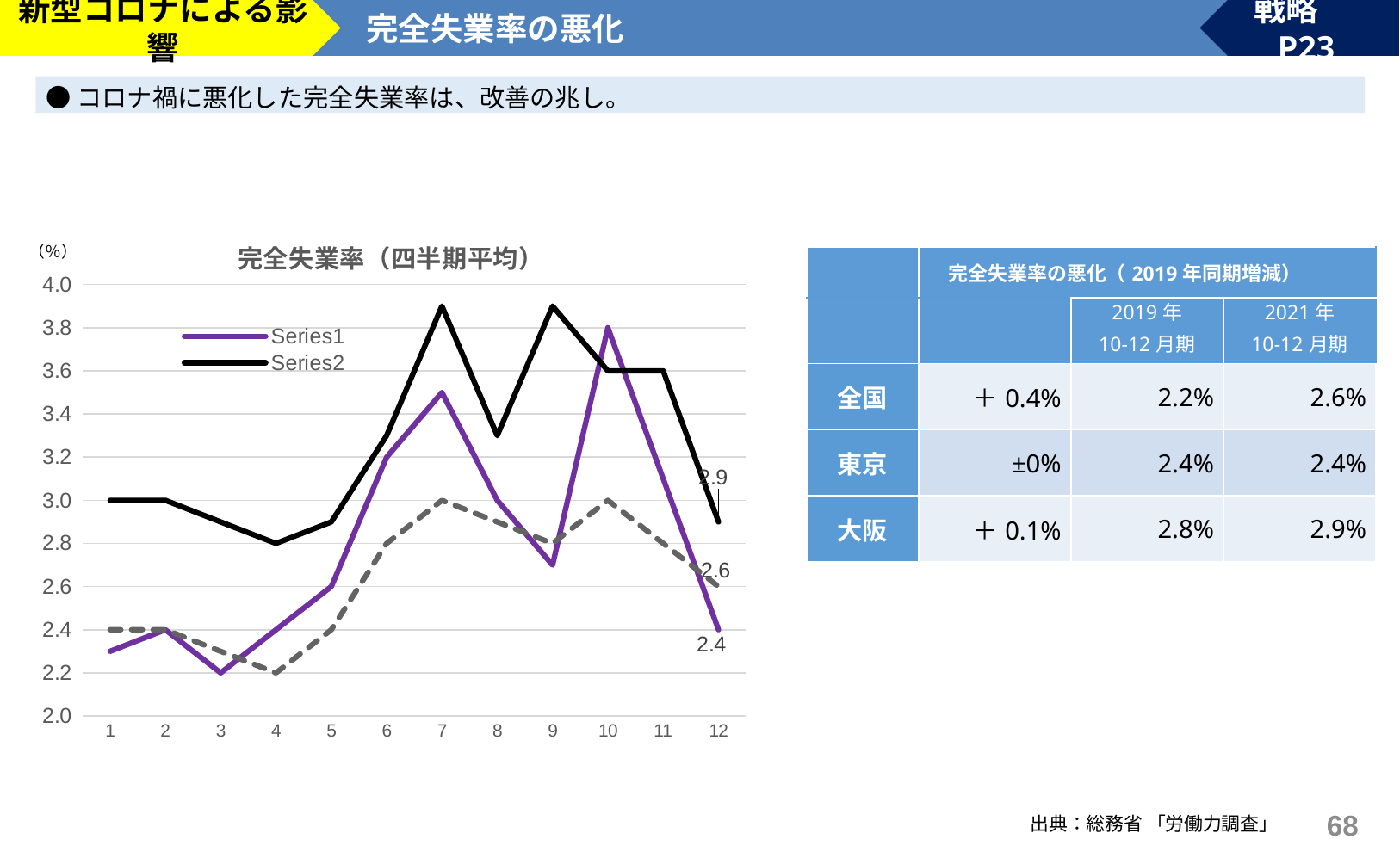
What is the value of Series2 at point 12? 2.9 Is the value of Series1 at point 3 greater or less than 2.4? less Does Series1 rise or fall from point 10 to point 12? fall What is the value of Series1 at point 12? 2.4 What kind of chart is shown on the slide? line chart Is the value of Series2 at point 7 greater or less than 3.6? greater At point 12, which is larger, Series1 or Series2? Series2 How many series does the chart legend list? 2 What is the difference between Series2 and Series1 at point 12? 0.5 How many points are on the x axis of the chart? 12 What is the title of the chart? 完全失業率（四半期平均） At which x-axis point does Series1 reach its highest value? 10